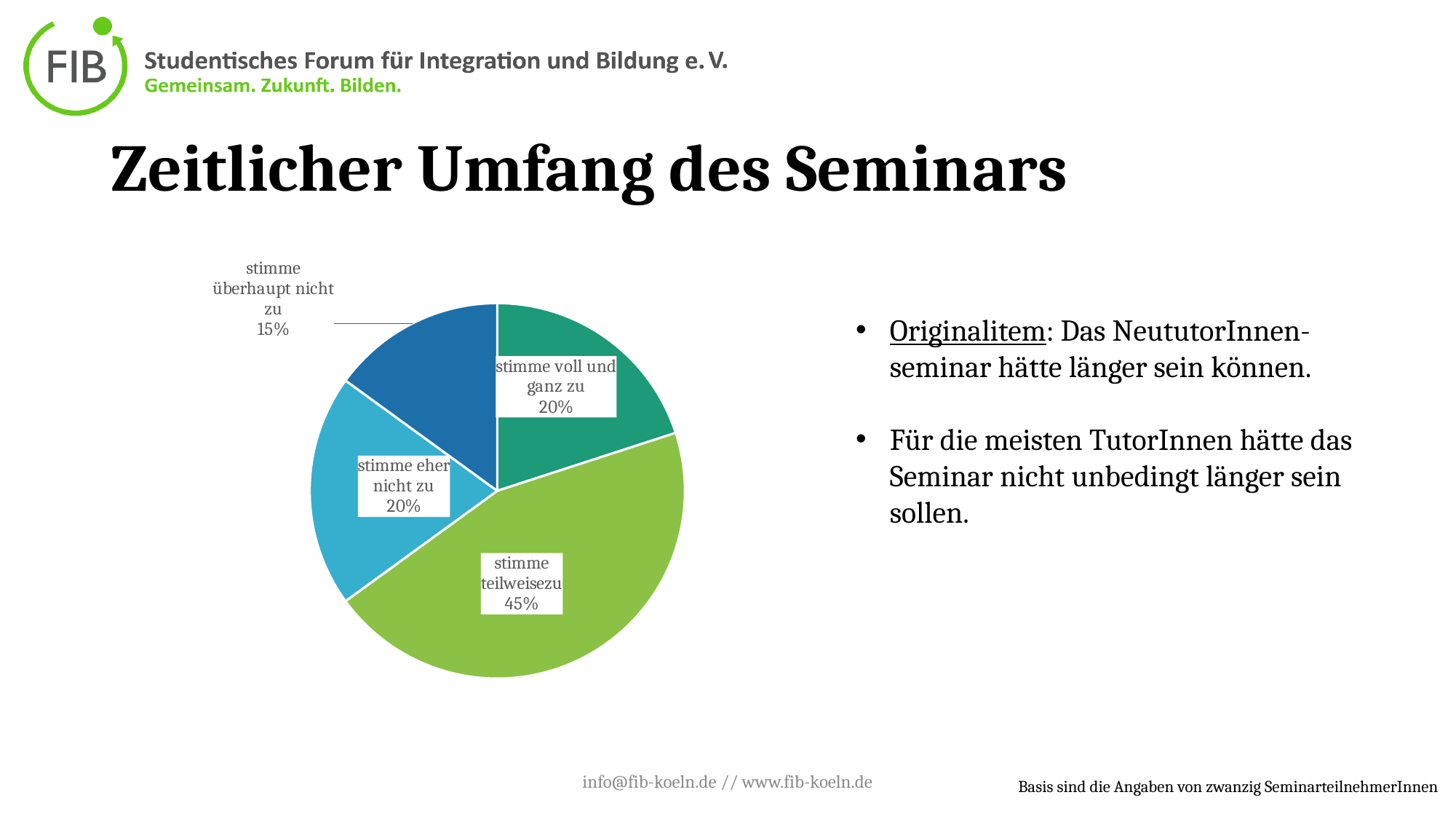
What kind of chart is shown on the slide? pie chart What share of the pie does "stimme überhaupt nicht zu" represent? 15% What share of the pie does "stimme voll und ganz zu" represent? 20% Which category has the smallest slice of the pie? stimme überhaupt nicht zu What is the difference between the shares for "stimme teilweise zu" and "stimme eher nicht zu"? 25% What is the value for "stimme eher nicht zu"? 20% What colour is the "stimme teilweise zu" slice? green How many slices does the pie chart have? 4 What is the difference between the shares for "stimme voll und ganz zu" and "stimme überhaupt nicht zu"? 5% What share of the pie does "stimme teilweise zu" represent? 45% Which is larger: the share for "stimme teilweise zu" or the share for "stimme überhaupt nicht zu"? stimme teilweise zu Which category has the largest slice of the pie? stimme teilweise zu